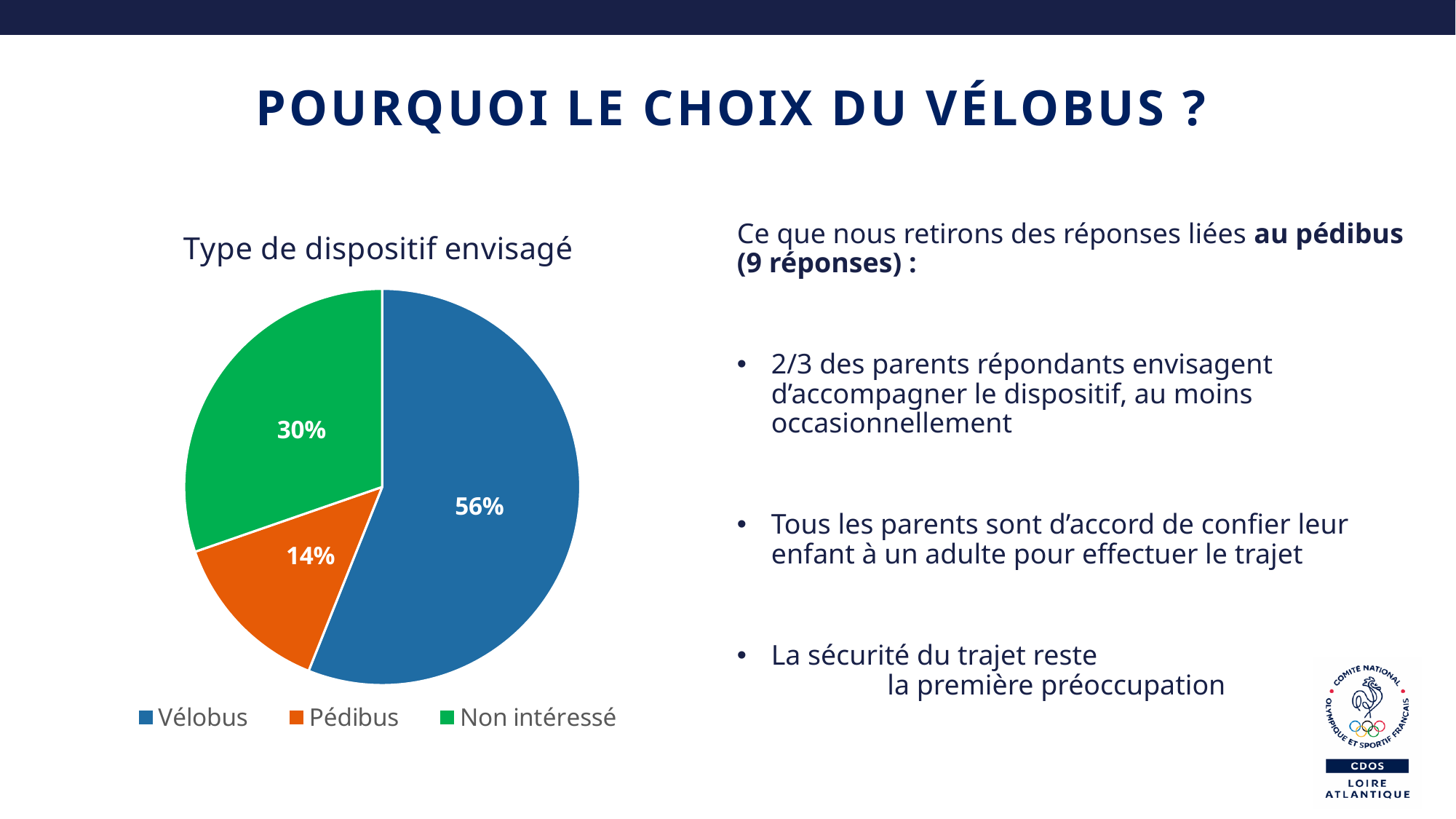
What is the difference in percentage points between the Vélobus and Non intéressé slices? 26 Which category has the largest slice of the pie? Vélobus What share of the pie does Pédibus represent? 14% What kind of chart is shown on the slide? Pie chart What colour is the Pédibus slice in the pie chart? Orange Which slice is larger, Pédibus or Non intéressé? Non intéressé What share of the pie does Vélobus represent? 56% What share of the pie does Non intéressé represent? 30% What is the difference in percentage points between the Non intéressé and Pédibus slices? 16 How many categories does the pie chart show? 3 What is the title of the chart? Type de dispositif envisagé Which category has the smallest slice of the pie? Pédibus